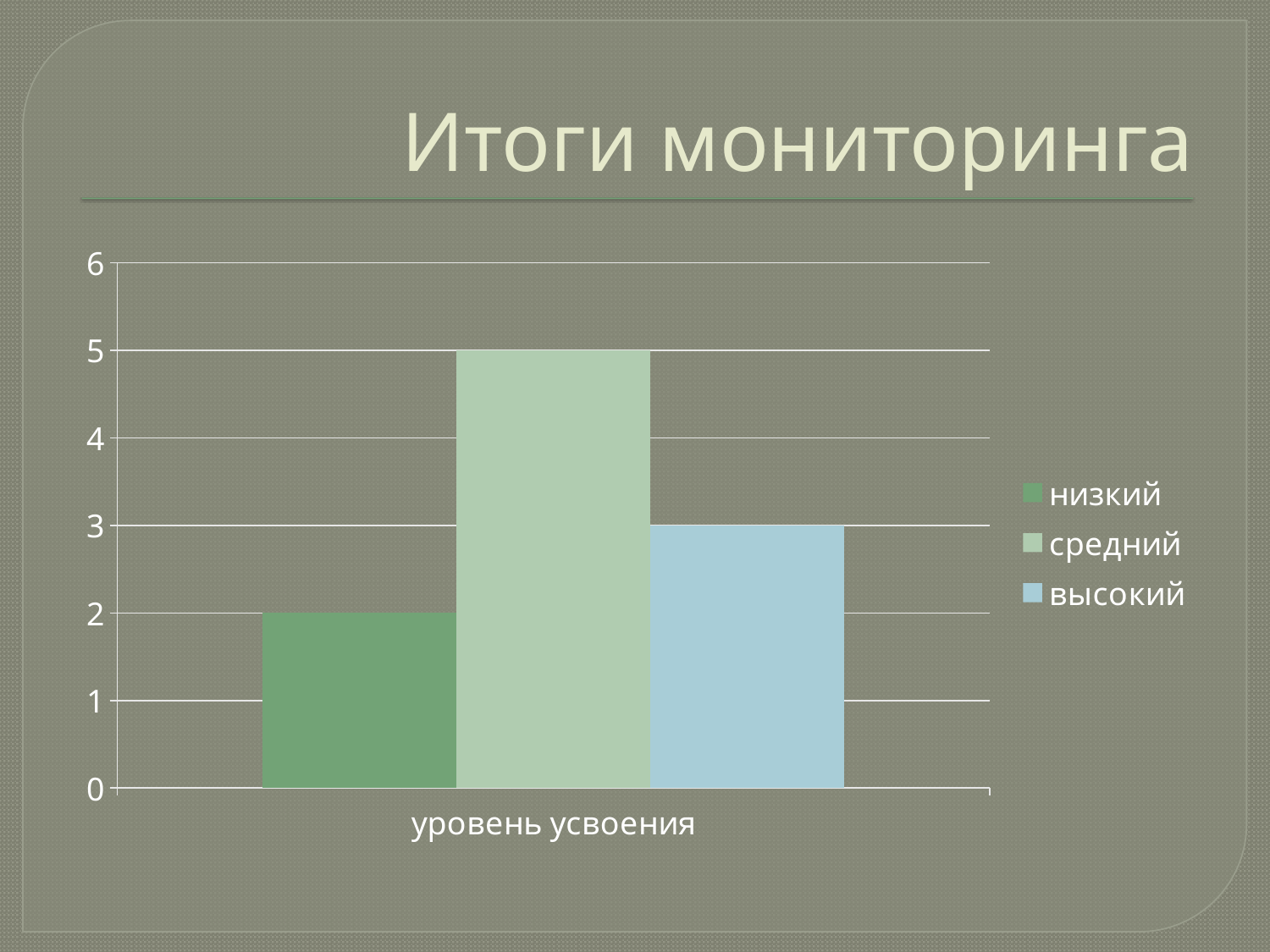
What type of chart is shown on the slide? bar chart What is the value for the series "высокий"? 3 Which series has the lowest value? низкий Which is larger, the value for "высокий" or the value for "низкий"? высокий What is the difference between the values for "высокий" and "низкий"? 1 How many series does the legend list? 3 What is the value for the series "низкий"? 2 What is the title of the slide containing the chart? Итоги мониторинга What is the value for the series "средний"? 5 Which series has the highest value? средний Is the value for "средний" greater or less than 4? greater What is the difference between the values for "средний" and "низкий"? 3